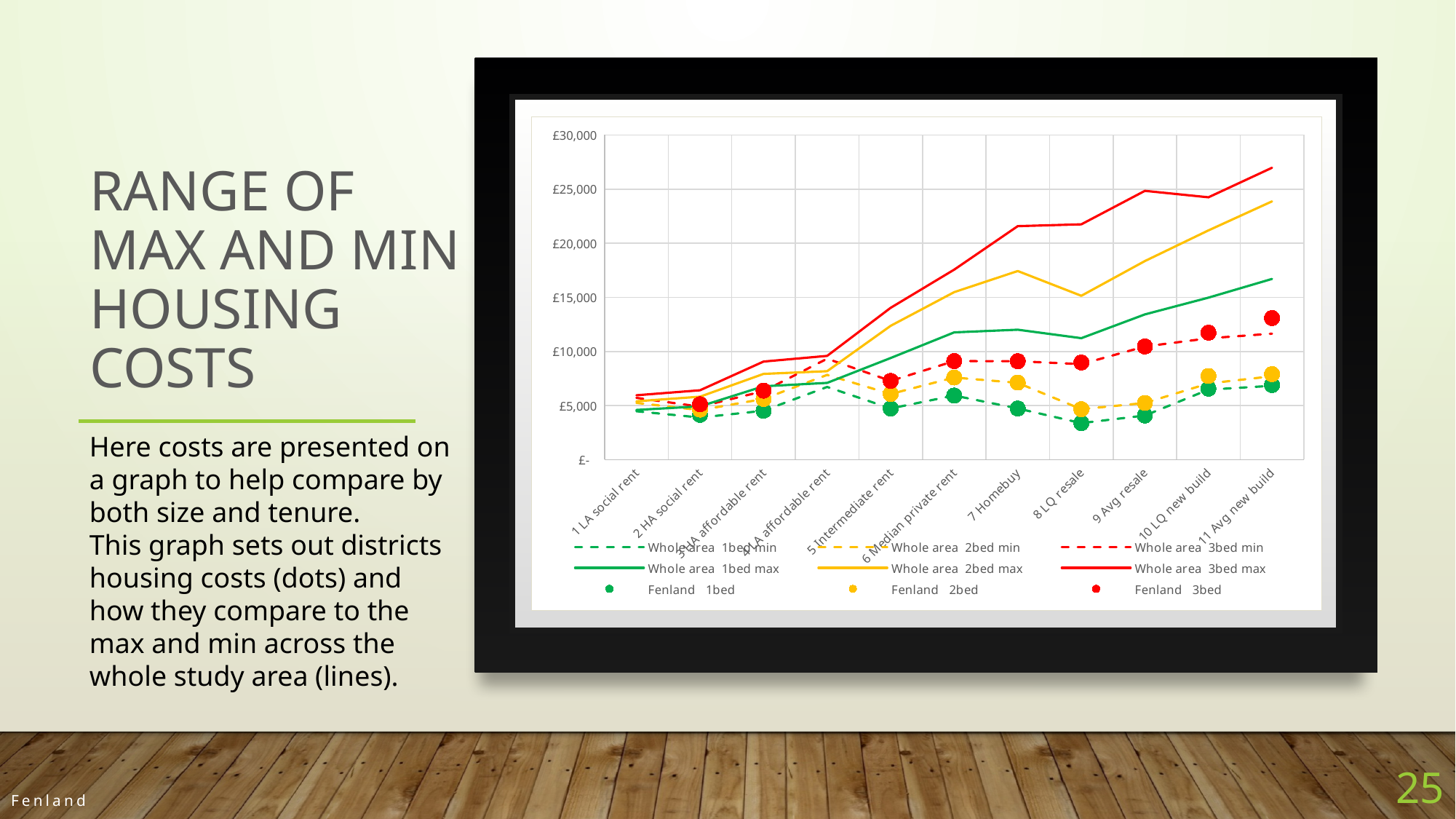
Is the value of Whole area 1bed max for 11 Avg new build greater or less than £15,000? greater What colour is used for the 3bed series in the chart's legend? red Is the value of Whole area 3bed max for 11 Avg new build greater or less than £25,000? greater For which category is the Whole area 3bed max line at its highest? 11 Avg new build How many categories are shown along the x axis of the chart? 11 Does the Whole area 3bed max line rise or fall from 4 LA affordable rent to 7 Homebuy? rise How many series does the chart's legend list? 9 Is the value of Whole area 3bed max for 7 Homebuy greater or less than £20,000? greater At 11 Avg new build, which is larger: Whole area 3bed max or Whole area 2bed max? Whole area 3bed max What kind of chart is shown on the slide? line chart